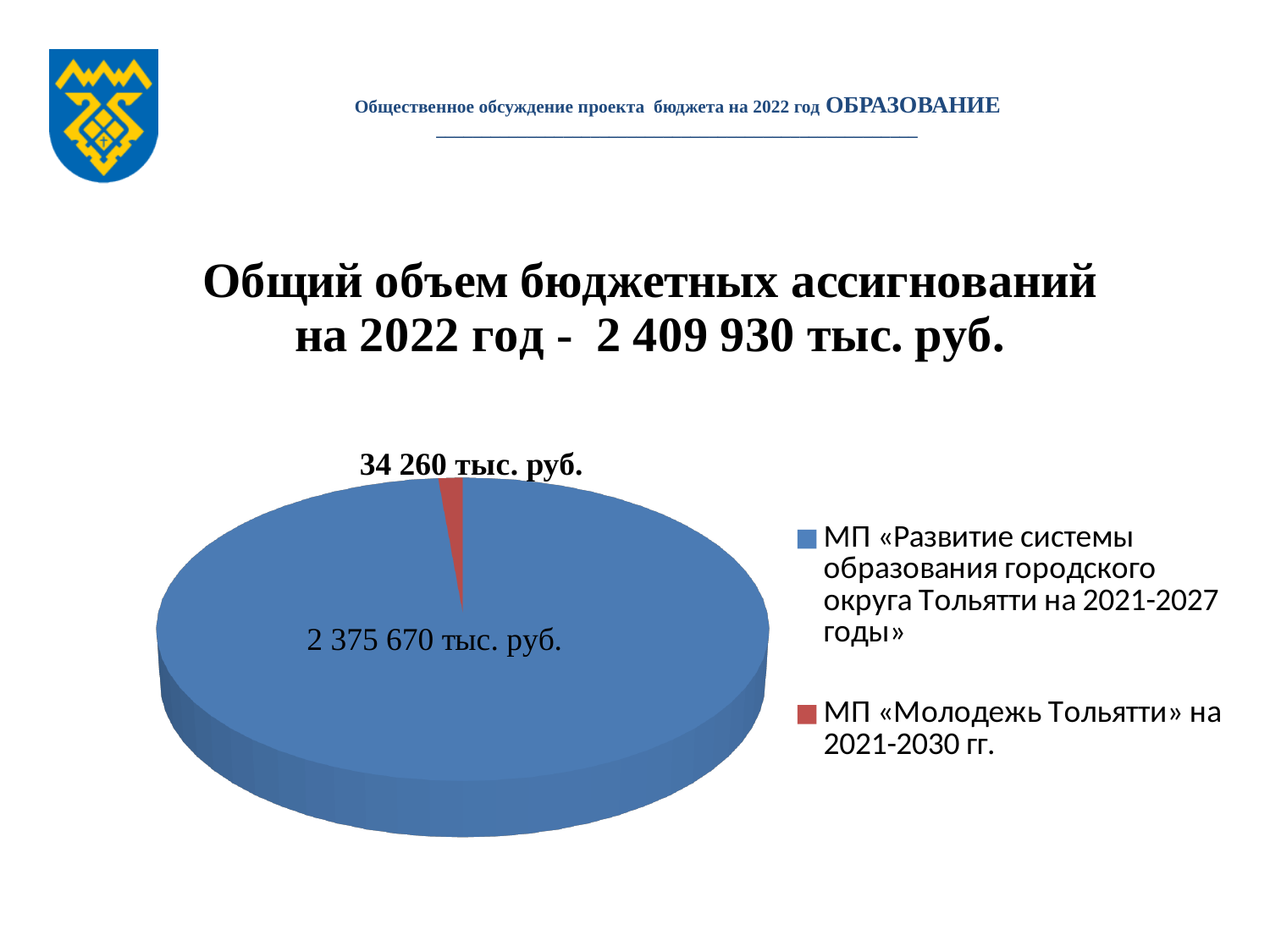
Which program has the smallest slice of the pie? МП «Молодежь Тольятти» на 2021-2030 гг. Which is larger: the value for МП «Развитие системы образования» or the value for МП «Молодежь Тольятти»? МП «Развитие системы образования» How many slices does the pie chart have? 2 What kind of chart is shown on the slide? Pie chart What is the value for МП «Молодежь Тольятти» на 2021-2030 гг.? 34 260 тыс. руб. Which program has the largest slice of the pie? МП «Развитие системы образования городского округа Тольятти на 2021-2027 годы» What is the difference between the value for МП «Развитие системы образования» and the value for МП «Молодежь Тольятти»? 2 341 410 тыс. руб. What is the value for МП «Развитие системы образования городского округа Тольятти на 2021-2027 годы»? 2 375 670 тыс. руб. What total budget allocation for 2022 is stated in the slide title? 2 409 930 тыс. руб. What is the total of the two slices in the pie chart? 2 409 930 тыс. руб. How many series does the legend list? 2 What colour is the slice for МП «Молодежь Тольятти» на 2021-2030 гг.? Red